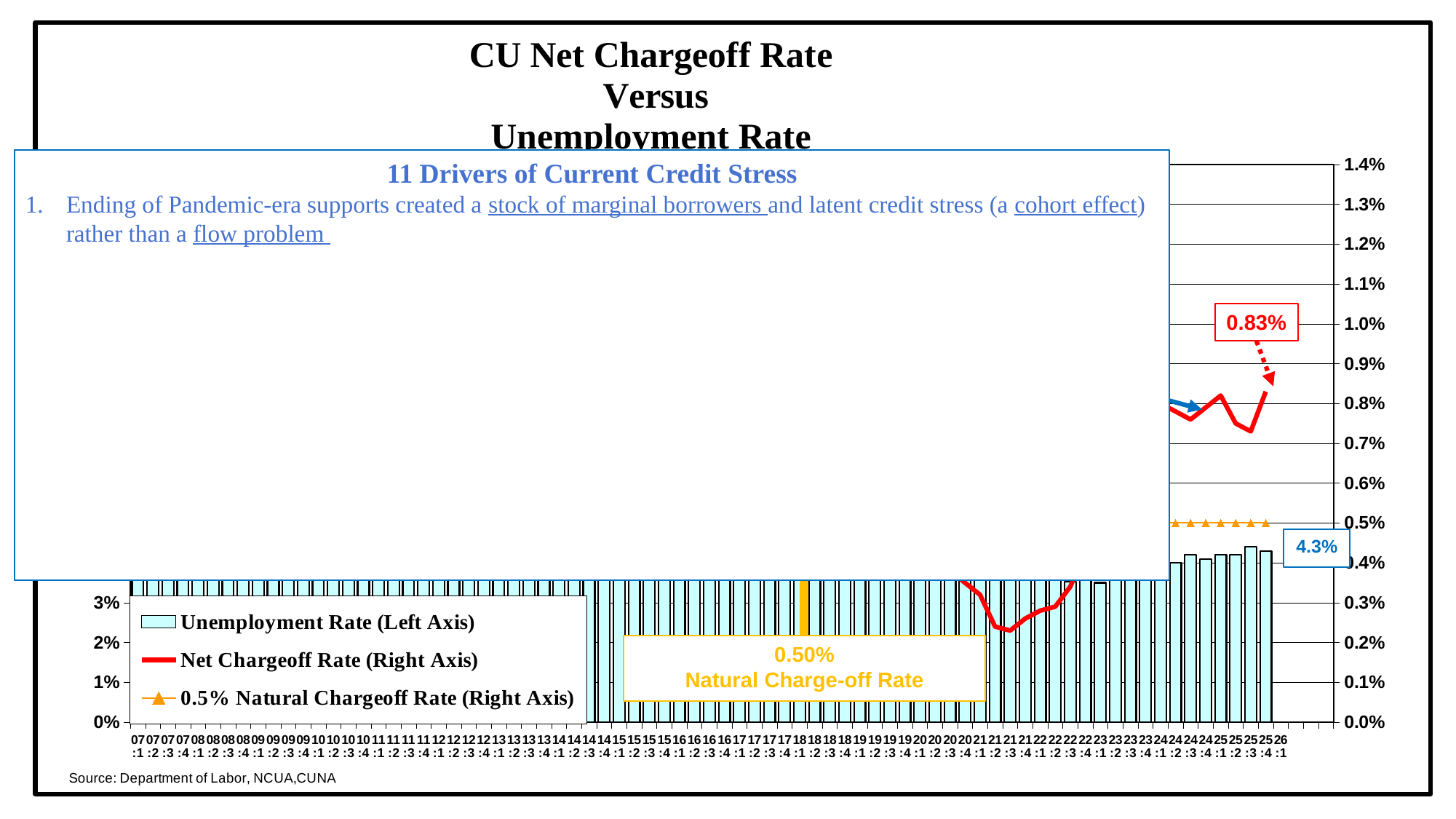
What value is labeled for the most recent Unemployment Rate bar? 4.3% Is the Net Chargeoff Rate at 25:4 greater or less than 0.5%? greater On which axis is the Net Chargeoff Rate plotted? Right Axis What is the Natural Charge-off Rate shown on the chart? 0.50% How many series does the chart legend list? 3 What value is labeled for the projected Net Chargeoff Rate at the right end of the red line? 0.83% Is the Net Chargeoff Rate around 21:3 greater or less than 0.3%? less What is the title of the chart? CU Net Chargeoff Rate Versus Unemployment Rate Is the Net Chargeoff Rate at 25:3 greater or less than 0.8%? less What kind of chart is used to plot the Unemployment Rate series? bar chart